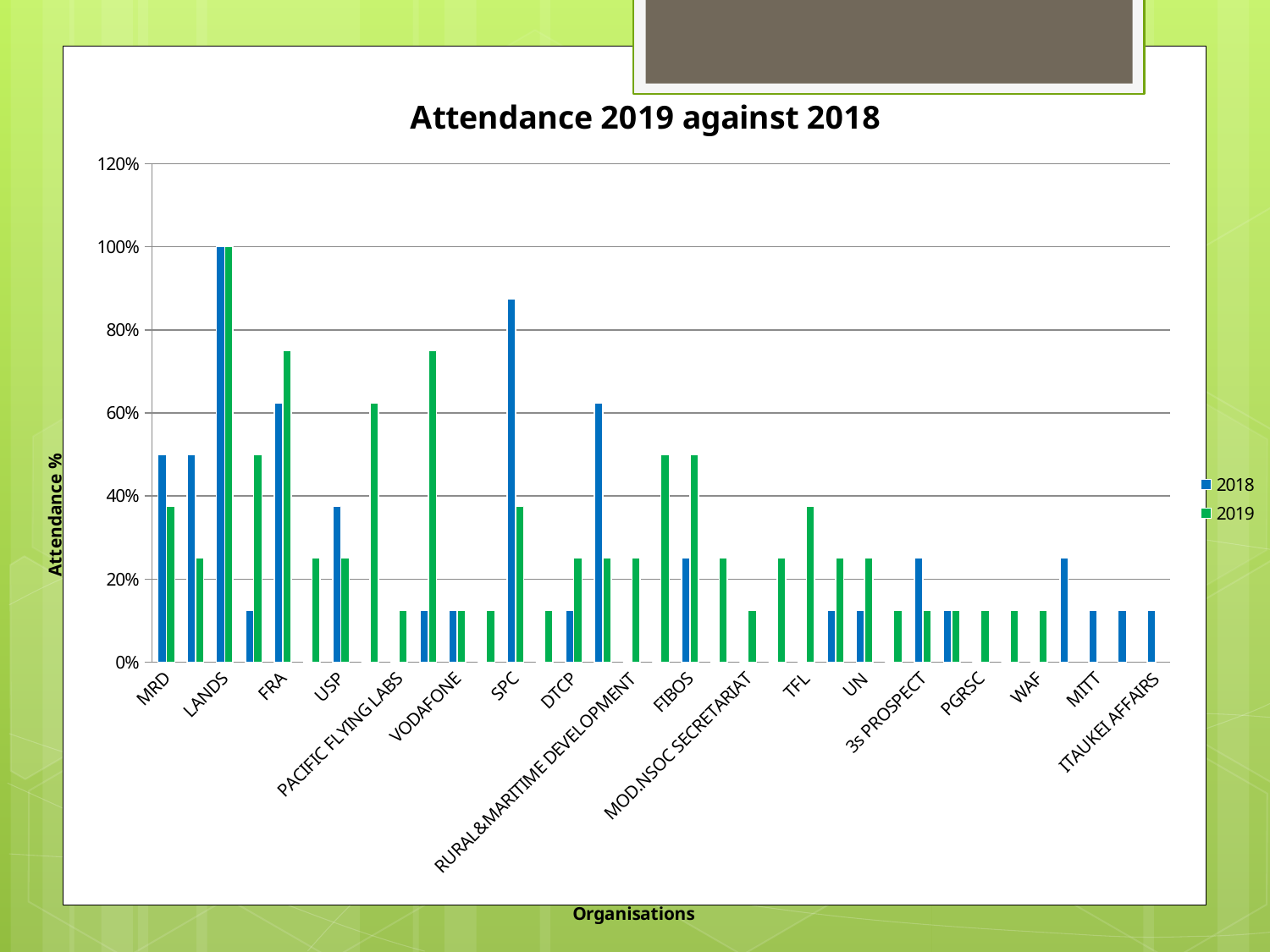
Is the 2018 attendance value for SPC greater or less than 80%? greater For SPC, which series has the larger value, 2018 or 2019? 2018 Is the 2018 attendance value for MITT greater or less than 20%? less What are the two series named in the legend? 2018 and 2019 Is the 2019 attendance value for FRA greater or less than 60%? greater What is the title of the chart? Attendance 2019 against 2018 What type of chart is shown on the slide? bar chart How many series does the legend list? 2 What is the 2018 attendance value for LANDS? 100% What is the 2019 attendance value for LANDS? 100% Which organisation has the highest 2019 attendance? LANDS For FRA, which series has the larger value, 2018 or 2019? 2019